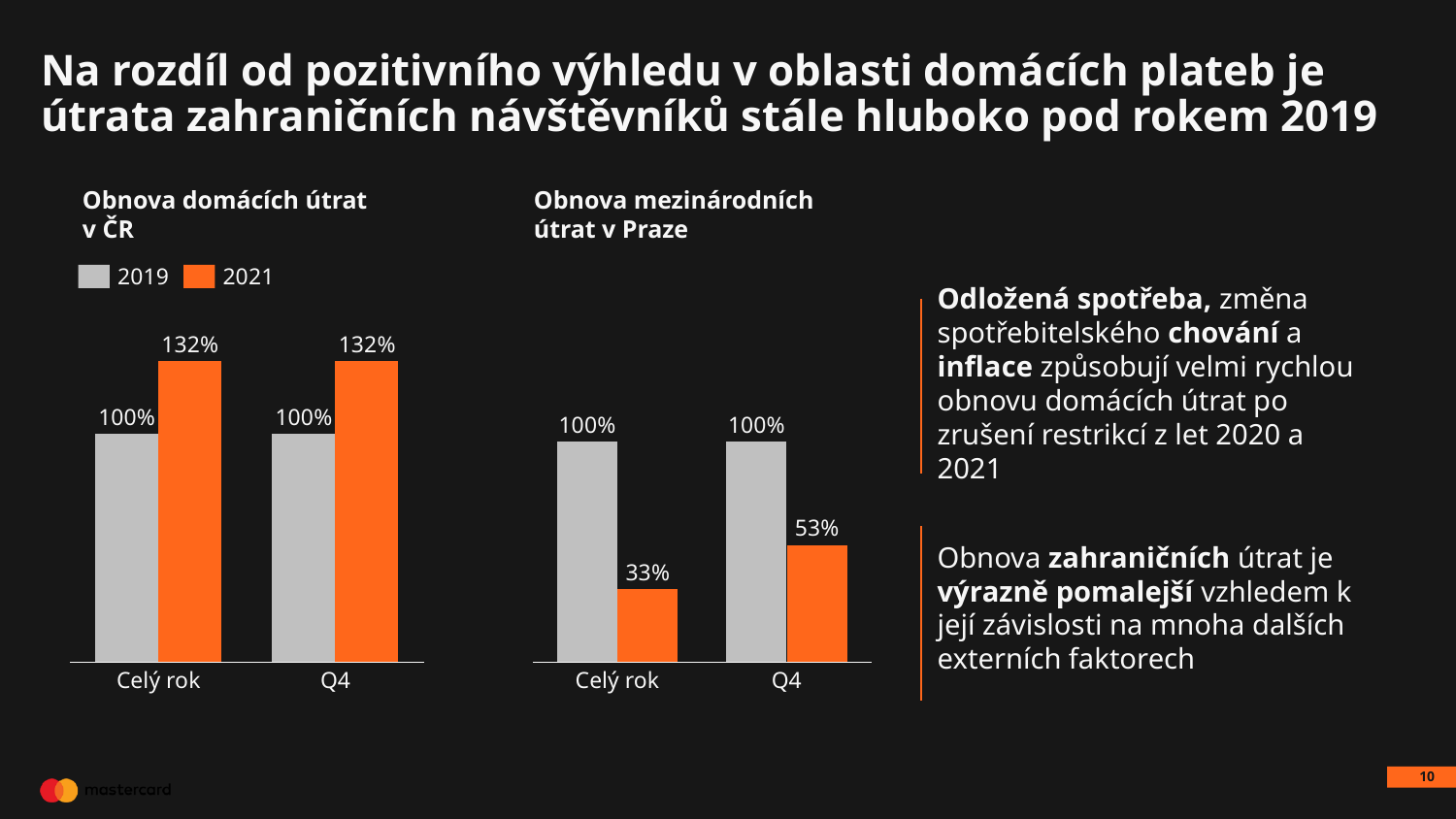
In the chart 'Obnova domácích útrat v ČR', what is the 2021 value for Celý rok? 132% In the chart 'Obnova mezinárodních útrat v Praze', what is the difference between the 2021 values for Q4 and Celý rok? 20% In the chart 'Obnova mezinárodních útrat v Praze', what is the 2021 value for Q4? 53% In the chart 'Obnova domácích útrat v ČR', what is the difference between the 2021 and 2019 values for Celý rok? 32% What kind of chart is 'Obnova domácích útrat v ČR'? bar chart How many categories are shown on the x axis of the chart 'Obnova mezinárodních útrat v Praze'? 2 In the chart 'Obnova mezinárodních útrat v Praze', what is the 2021 value for Celý rok? 33% In the chart 'Obnova domácích útrat v ČR', is the 2021 value for Q4 larger or smaller than the 2019 value for Q4? larger How many series does the legend list for the charts on the slide? 2 In the chart 'Obnova mezinárodních útrat v Praze', which category has the lowest 2021 value? Celý rok In the chart 'Obnova mezinárodních útrat v Praze', is the 2021 value for Q4 larger or smaller than the 2019 value for Q4? smaller In the chart 'Obnova domácích útrat v ČR', what is the 2019 value for Q4? 100%